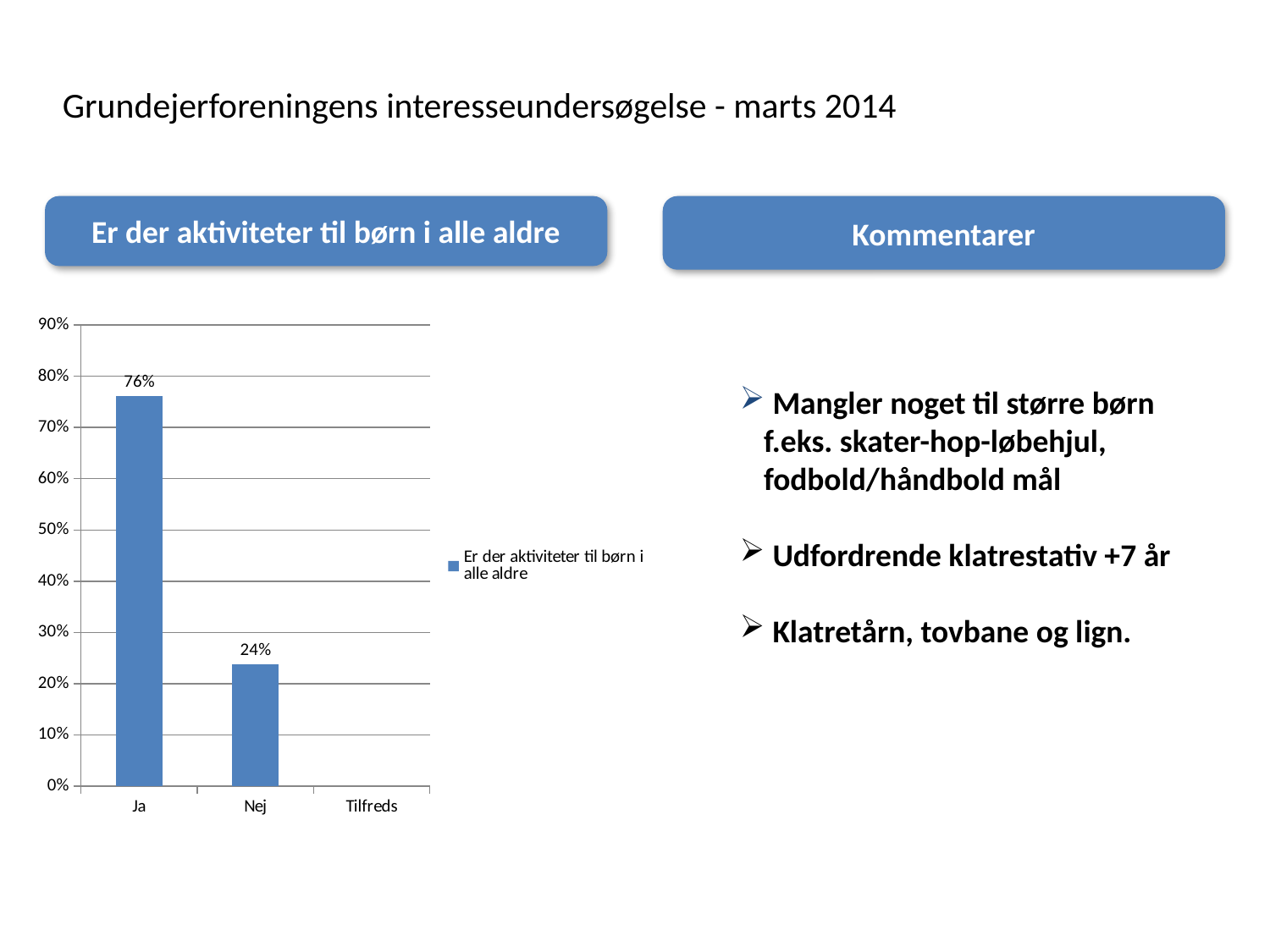
What is the value for Nej? 24% What is the legend entry for the series? Er der aktiviteter til børn i alle aldre Is the value for Ja greater or less than 70%? greater Which is larger, the value for Ja or the value for Nej? Ja What kind of chart is shown? Bar chart Is the value for Nej greater or less than 30%? less What is the difference between the values for Ja and Nej? 52% Which category has the highest value? Ja How many series does the legend list? 1 What is the value for Ja? 76% How many categories are shown on the x axis? 3 What is the highest value shown on the y axis? 90%